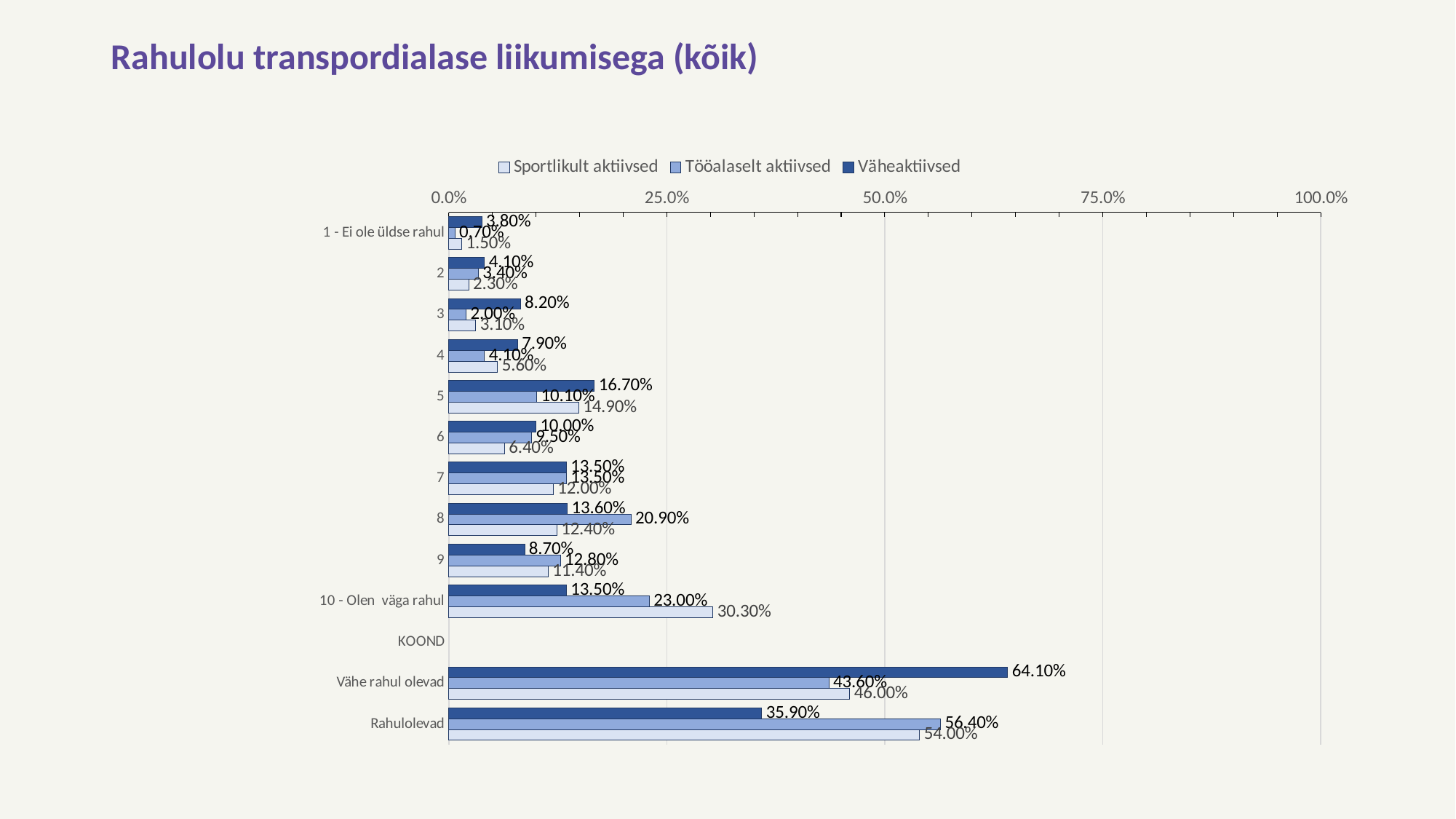
Which series has the lowest value in the category '1 - Ei ole üldse rahul'? Tööalaselt aktiivsed What type of chart is shown on the slide? bar chart What is the value for Tööalaselt aktiivsed in the category 'Rahulolevad'? 56.40% What is the title of the chart? Rahulolu transpordialase liikumisega (kõik) What is the value for Tööalaselt aktiivsed in category 8? 20.90% What is the value for Sportlikult aktiivsed in the category '10 - Olen väga rahul'? 30.30% What is the difference between the Väheaktiivsed and Sportlikult aktiivsed values in the category 'Vähe rahul olevad'? 18.10% Which series has the highest value in the category 'Rahulolevad'? Tööalaselt aktiivsed What is the value for Väheaktiivsed in the category 'Vähe rahul olevad'? 64.10% Is the value for Väheaktiivsed in 'Vähe rahul olevad' greater or less than 50.0%? greater How many series does the legend list? 3 In category 5, which is larger: the Väheaktiivsed value or the Tööalaselt aktiivsed value? Väheaktiivsed